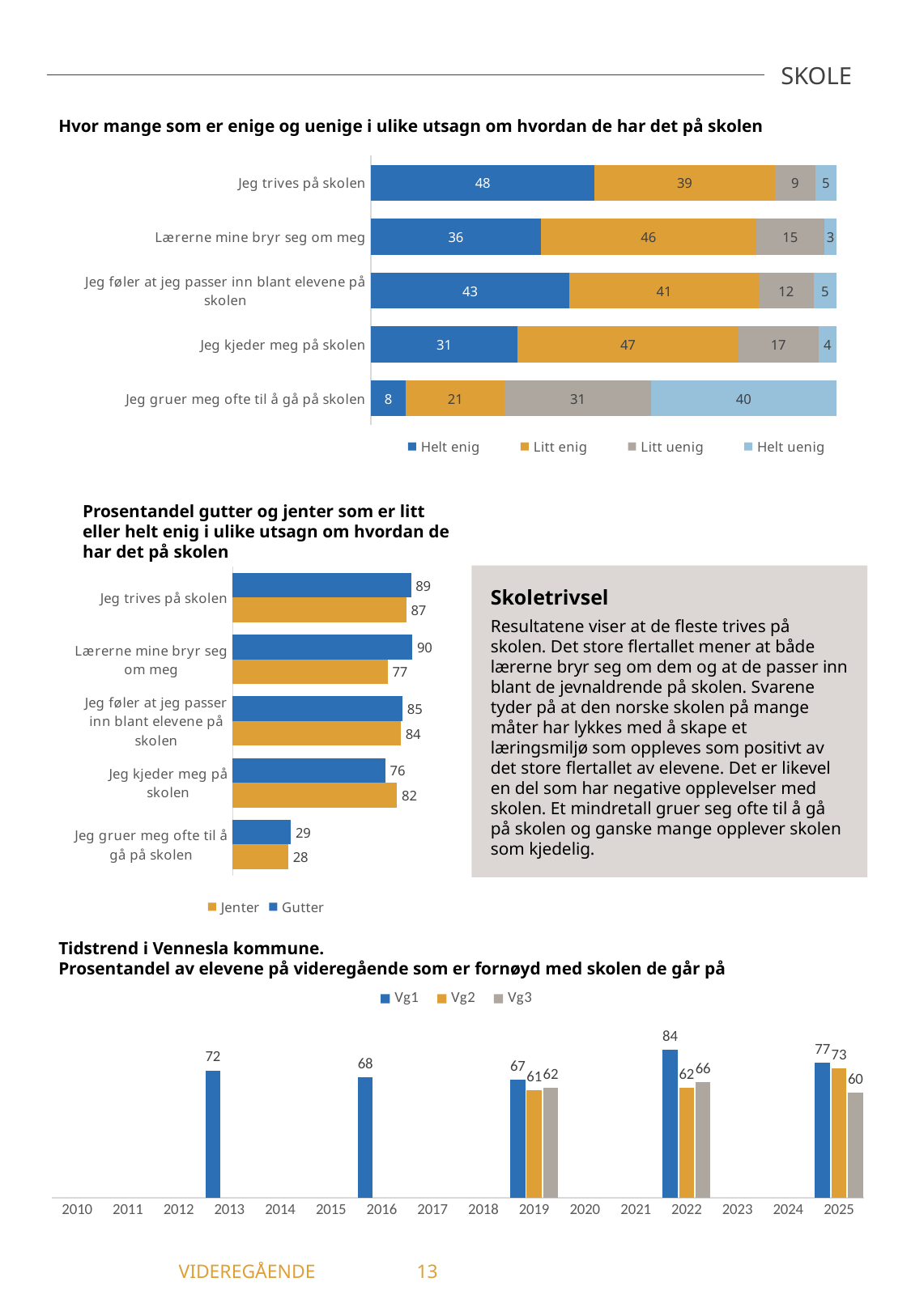
In the top chart 'Hvor mange som er enige og uenige i ulike utsagn om hvordan de har det på skolen', which statement has the highest 'Litt enig' value? Jeg kjeder meg på skolen In the middle chart 'Prosentandel gutter og jenter som er litt eller helt enig i ulike utsagn om hvordan de har det på skolen', what is the difference between Gutter and Jenter for 'Lærerne mine bryr seg om meg'? 13 In the bottom chart 'Tidstrend i Vennesla kommune', what is the Vg1 value for 2022? 84 In the top chart 'Hvor mange som er enige og uenige i ulike utsagn om hvordan de har det på skolen', what is the 'Helt enig' value for 'Jeg trives på skolen'? 48 In the bottom chart 'Tidstrend i Vennesla kommune', which year has the lowest Vg3 value? 2025 In the top chart 'Hvor mange som er enige og uenige i ulike utsagn om hvordan de har det på skolen', what is the difference between the 'Helt enig' values for 'Jeg trives på skolen' and 'Lærerne mine bryr seg om meg'? 12 In the top chart 'Hvor mange som er enige og uenige i ulike utsagn om hvordan de har det på skolen', what is the 'Helt uenig' value for 'Jeg gruer meg ofte til å gå på skolen'? 40 In the middle chart 'Prosentandel gutter og jenter som er litt eller helt enig i ulike utsagn om hvordan de har det på skolen', what is the value for Gutter on 'Lærerne mine bryr seg om meg'? 90 In the middle chart 'Prosentandel gutter og jenter som er litt eller helt enig i ulike utsagn om hvordan de har det på skolen', which is larger for 'Jeg kjeder meg på skolen': Jenter or Gutter? Jenter What kind of chart is the bottom chart 'Tidstrend i Vennesla kommune'? Bar chart In the middle chart 'Prosentandel gutter og jenter som er litt eller helt enig i ulike utsagn om hvordan de har det på skolen', how many statements are shown? 5 In the top chart 'Hvor mange som er enige og uenige i ulike utsagn om hvordan de har det på skolen', how many series does the legend list? 4